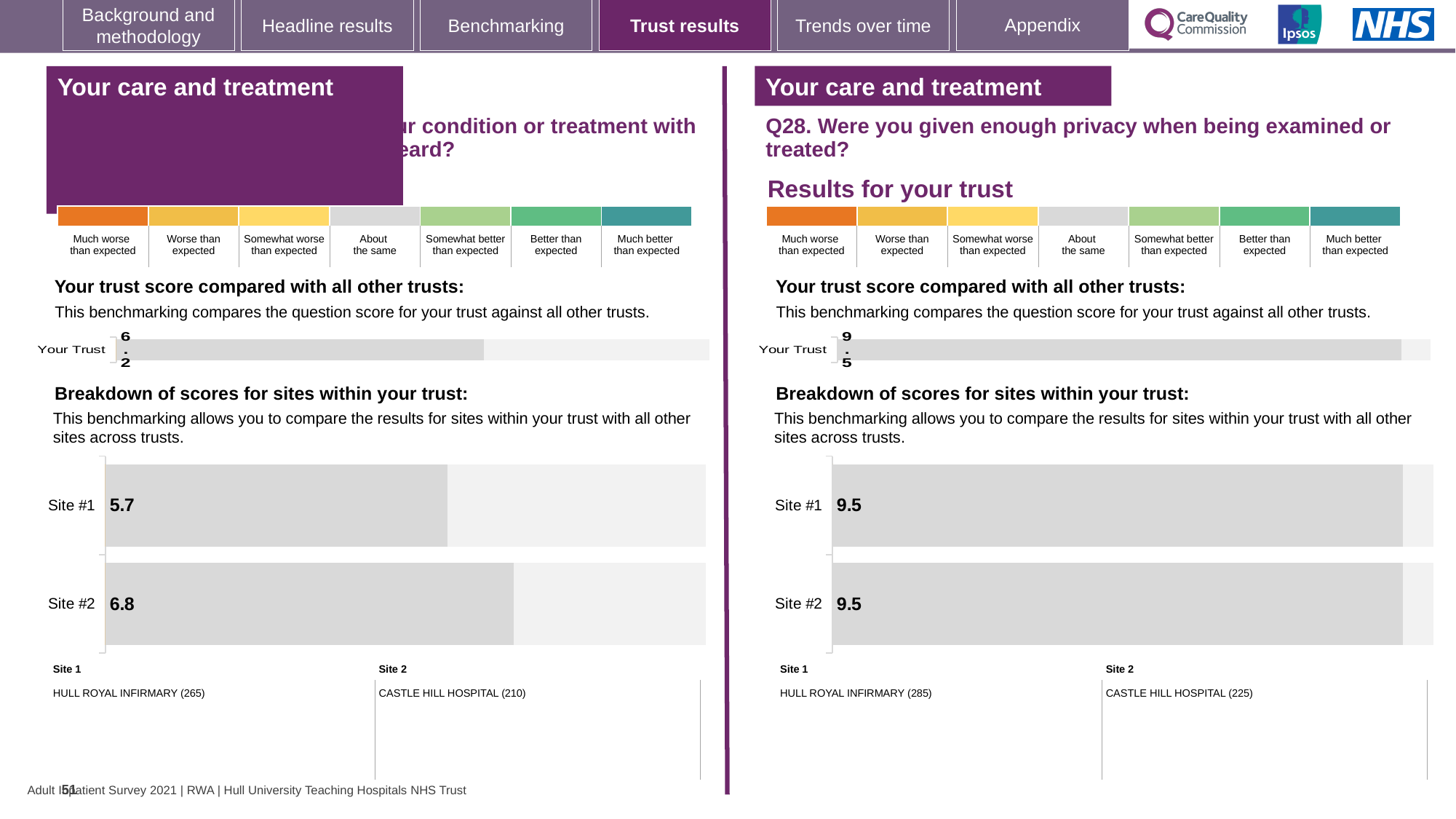
On the left-hand side of the slide, what is the score for Site #1 in the breakdown of scores for sites within your trust? 5.7 What type of chart is used for the breakdown of scores for sites within your trust on the left-hand side of the slide? Bar chart How many sites are shown in the breakdown of scores chart on the right-hand side (Q28)? 2 On the right-hand side (Q28), is the Site #1 score in the breakdown chart higher than, lower than, or equal to the Site #2 score? Equal On the left-hand side of the slide, what is the difference between the Site #2 and Site #1 scores in the breakdown chart? 1.1 On the left-hand side of the slide, which site has the lower score in the breakdown of scores for sites within your trust? Site #1 On the right-hand side (Q28), what is the score for Site #2 in the breakdown of scores for sites within your trust? 9.5 On the right-hand side (Q28), what is the score for Site #1 in the breakdown of scores for sites within your trust? 9.5 On the right-hand side (Q28), what is the 'Your Trust' score shown in the trust score comparison chart? 9.5 On the left-hand side of the slide, what is the score for Site #2 in the breakdown of scores for sites within your trust? 6.8 On the left-hand side of the slide, which site has the higher score in the breakdown of scores for sites within your trust? Site #2 On the left-hand side of the slide, what is the 'Your Trust' score shown in the trust score comparison chart? 6.2